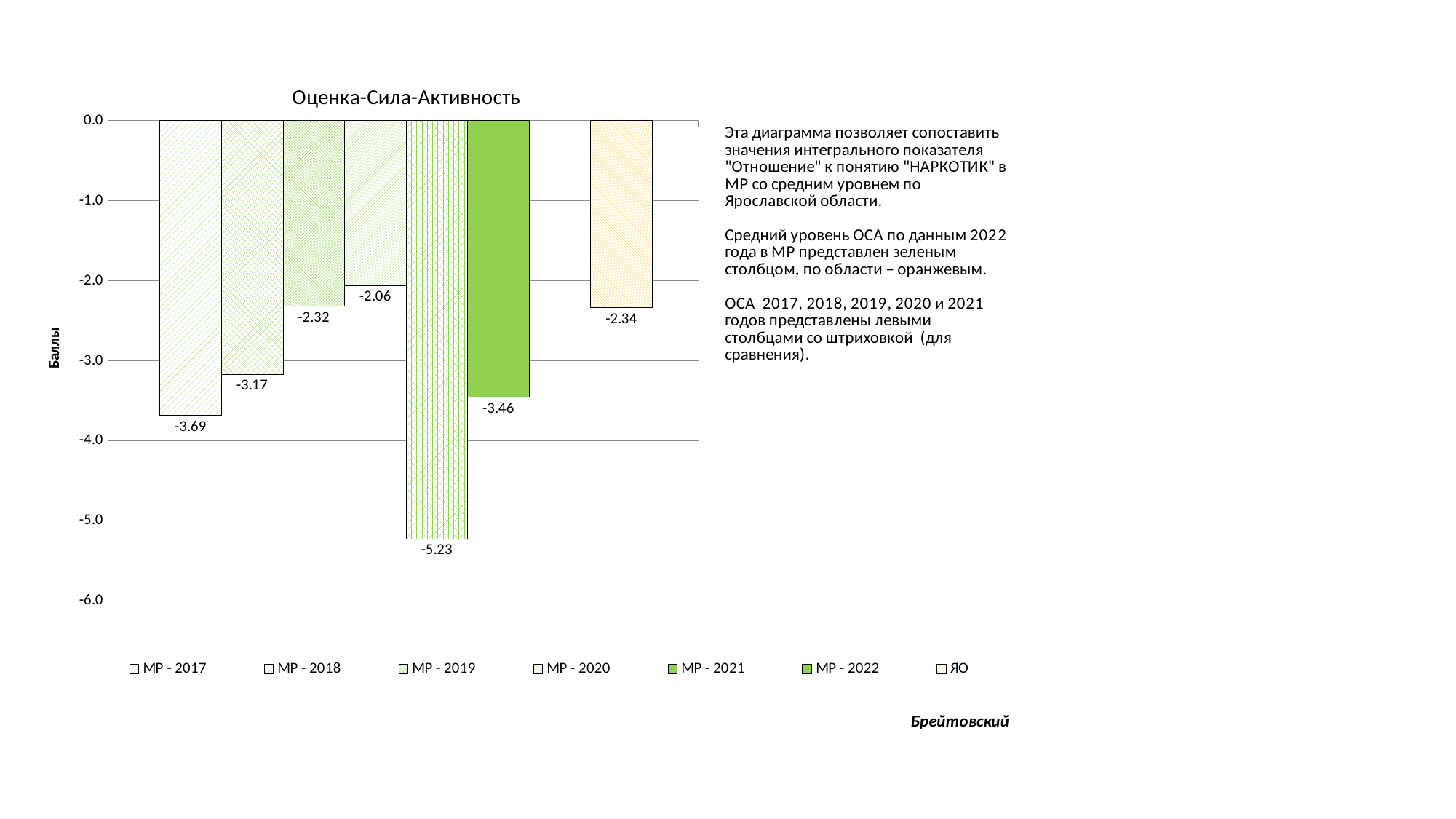
What is the title of the chart? Оценка-Сила-Активность What is the value for ЯО? -2.34 How many series does the legend list? 7 What kind of chart is shown? Bar chart What is the value for МР - 2017? -3.69 What is the difference between the values for МР - 2017 and МР - 2018? 0.52 What is the value for МР - 2021? -5.23 What is the value for МР - 2022? -3.46 What is the difference between the values for МР - 2022 and ЯО? 1.12 Which series has the lowest value? МР - 2021 Which series has the highest value? МР - 2020 Which is larger, the value for МР - 2019 or the value for МР - 2020? МР - 2020